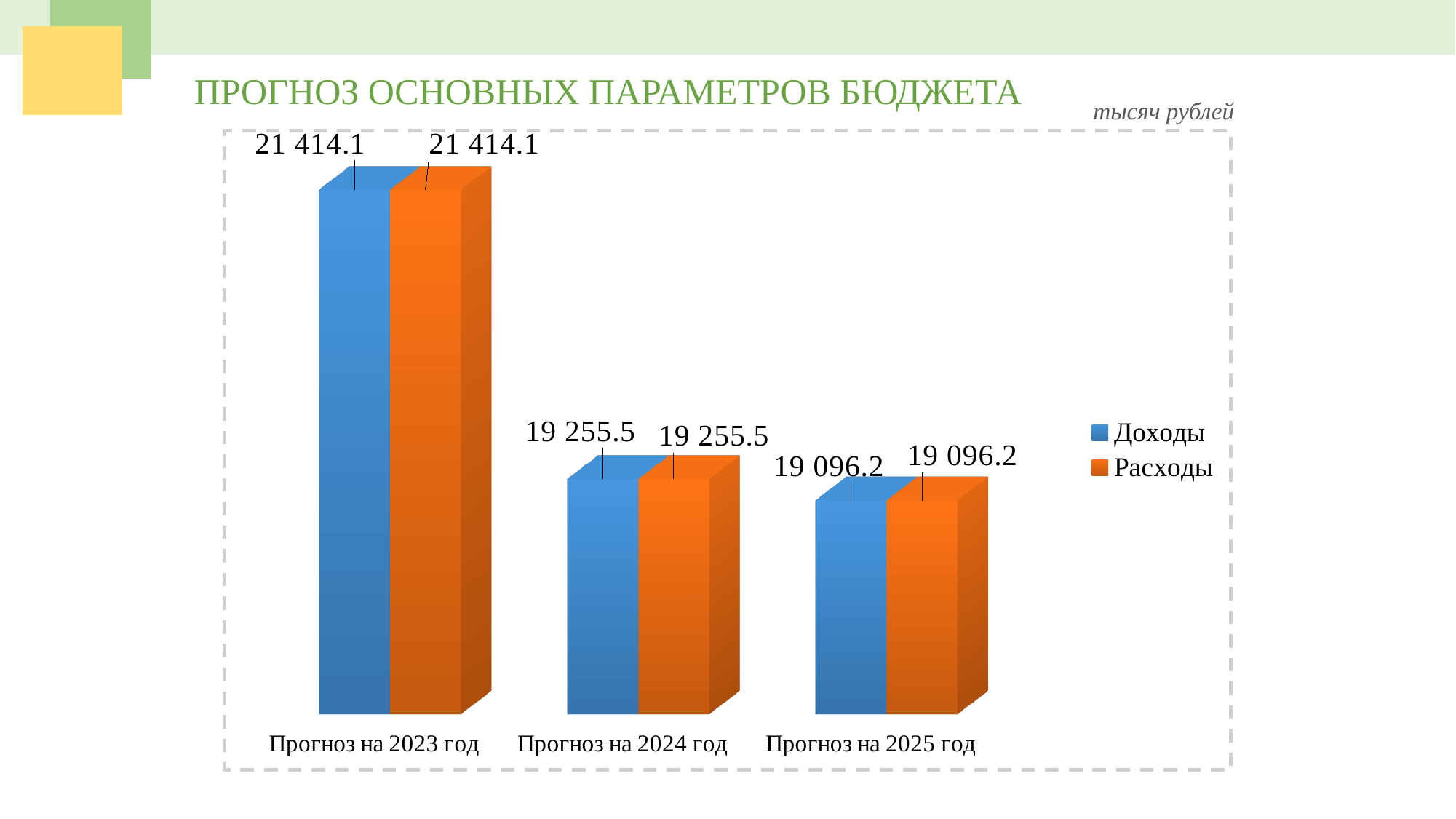
Which year has the highest Доходы value? Прогноз на 2023 год How many series does the legend list? 2 What is the value of Доходы for Прогноз на 2023 год? 21 414.1 What is the value of Доходы for Прогноз на 2025 год? 19 096.2 How many categories are shown on the x axis? 3 What is the value of Расходы for Прогноз на 2023 год? 21 414.1 What is the value of Расходы for Прогноз на 2024 год? 19 255.5 What is the difference between Расходы for Прогноз на 2024 год and Расходы for Прогноз на 2025 год? 159.3 What kind of chart is shown on the slide? Bar chart Which year has the lowest Расходы value? Прогноз на 2025 год What is the difference between Доходы for Прогноз на 2023 год and Доходы for Прогноз на 2024 год? 2 158.6 Which is larger: Доходы for Прогноз на 2024 год or Доходы for Прогноз на 2025 год? Прогноз на 2024 год